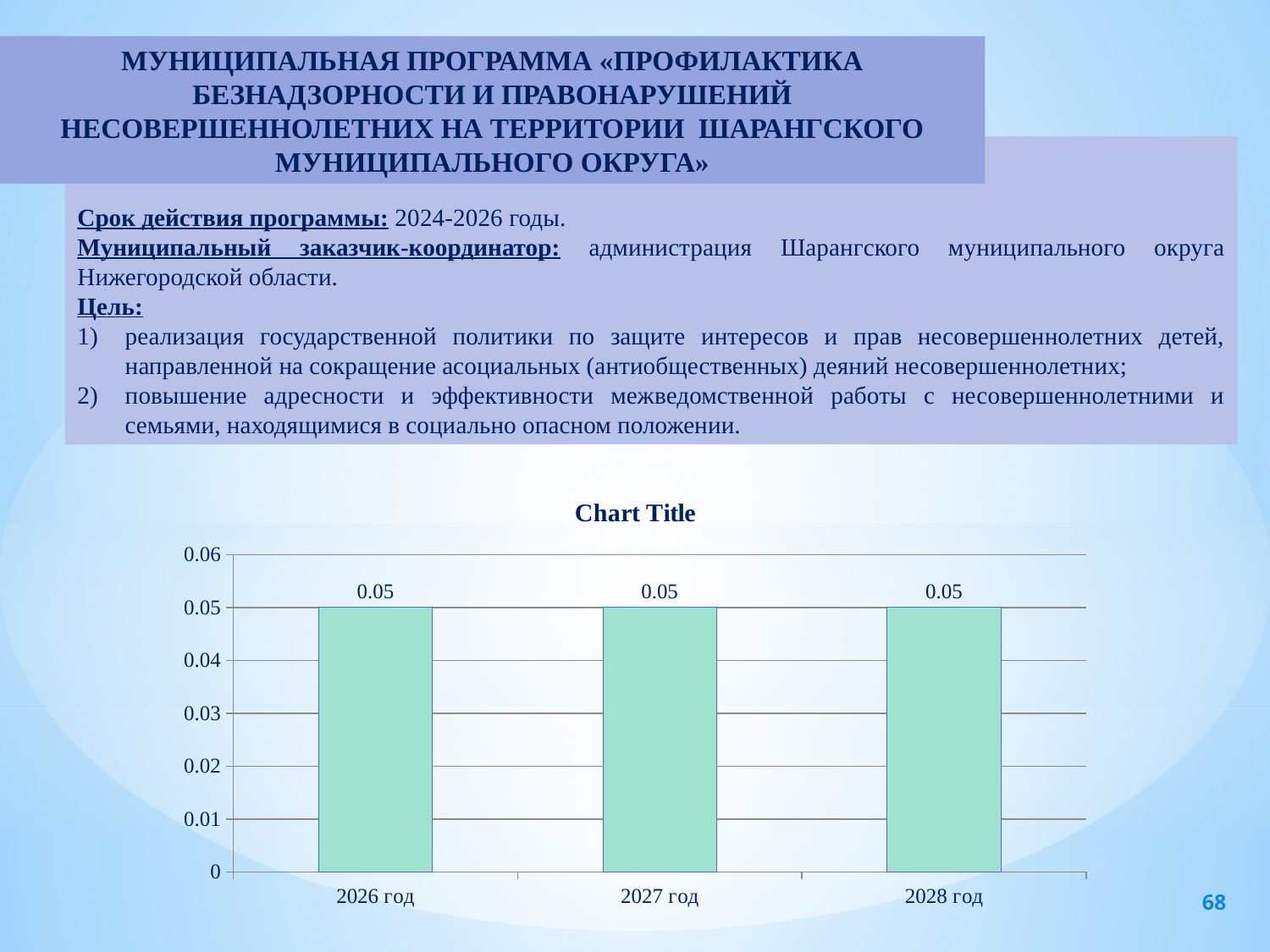
Is the value for 2028 год greater or less than 0.06? less What is the value for 2026 год? 0.05 What is the title of the chart? Chart Title What is the difference between the values for 2026 год and 2028 год? 0 What is the highest value shown on the y axis of the chart? 0.06 Do the values rise, fall or stay the same from 2026 год to 2028 год? stay the same What is the value for 2028 год? 0.05 What kind of chart is shown on the slide? bar chart Is the value for 2027 год greater or less than 0.04? greater How many categories are shown on the x axis of the chart? 3 What is the value for 2027 год? 0.05